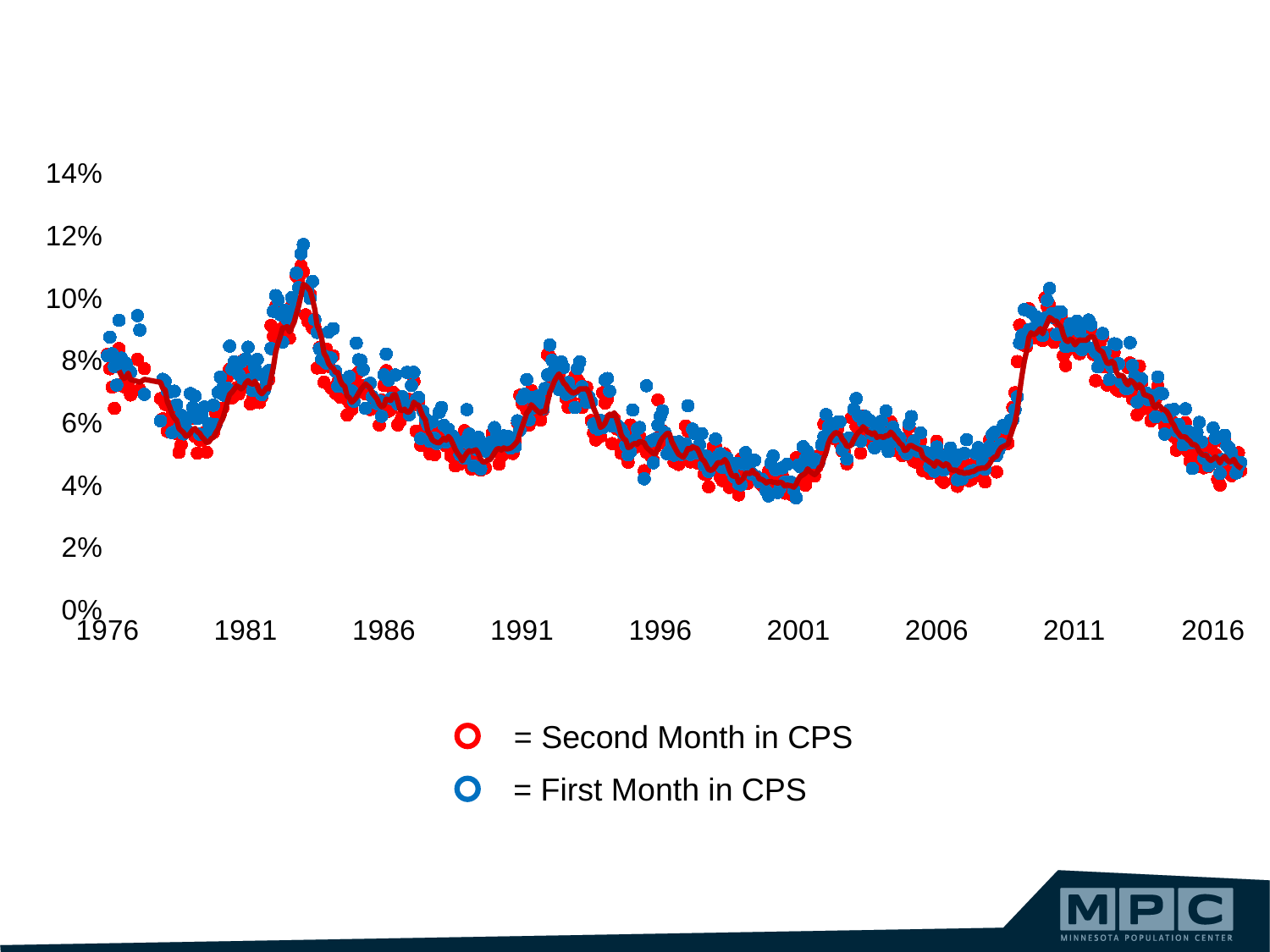
How many series does the legend list? 2 What is the highest value shown on the y axis? 14% What kind of chart is shown on the slide? scatter chart Which colour represents the 'Second Month in CPS' series? red Do the values rise or fall between 2011 and 2016? fall Is the value at 2016 greater or less than 6%? less Which is larger, the value around 2011 or the value around 2001? the value around 2011 Is the peak value reached between 1981 and 1986 greater or less than 10%? greater Is the value around 2011 greater or less than 8%? greater Do the values rise or fall between 2006 and 2011? rise